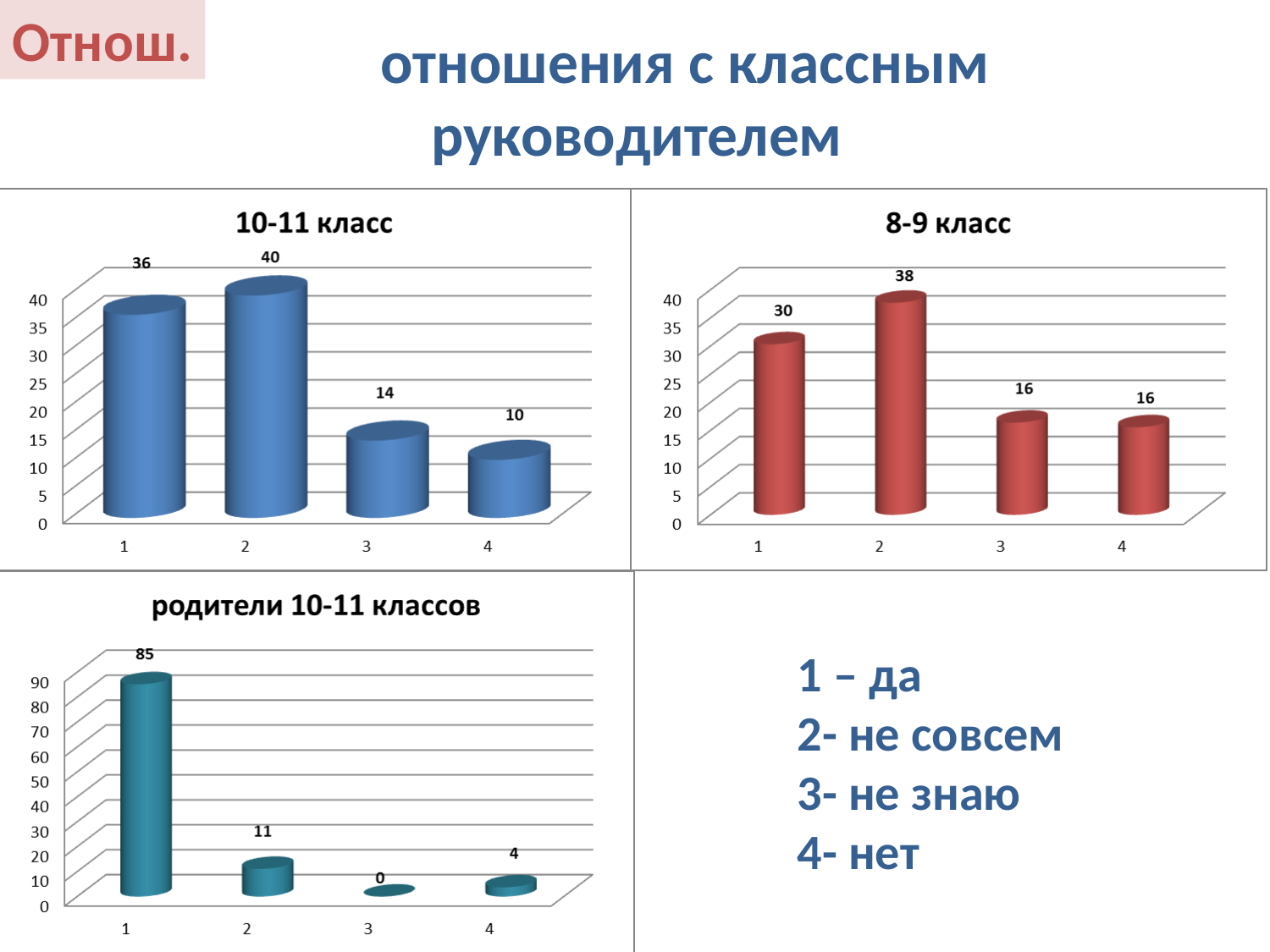
In the "8-9 класс" chart, what is the difference between the values for category 2 and category 4? 22 In the "10-11 класс" chart, what is the value for category 2? 40 In the "родители 10-11 классов" chart, which is larger, the value for category 2 or category 4? category 2 What type of chart is the "10-11 класс" chart? bar chart How many categories are shown in the "8-9 класс" chart? 4 In the "10-11 класс" chart, which category has the lowest value? 4 In the "8-9 класс" chart, which category has the highest value? 2 What colour are the bars in the "8-9 класс" chart? red In the "8-9 класс" chart, what is the value for category 1? 30 In the "10-11 класс" chart, what is the difference between the values for category 1 and category 3? 22 In the "родители 10-11 классов" chart, what is the value for category 1? 85 In the "родители 10-11 классов" chart, what is the value for category 3? 0